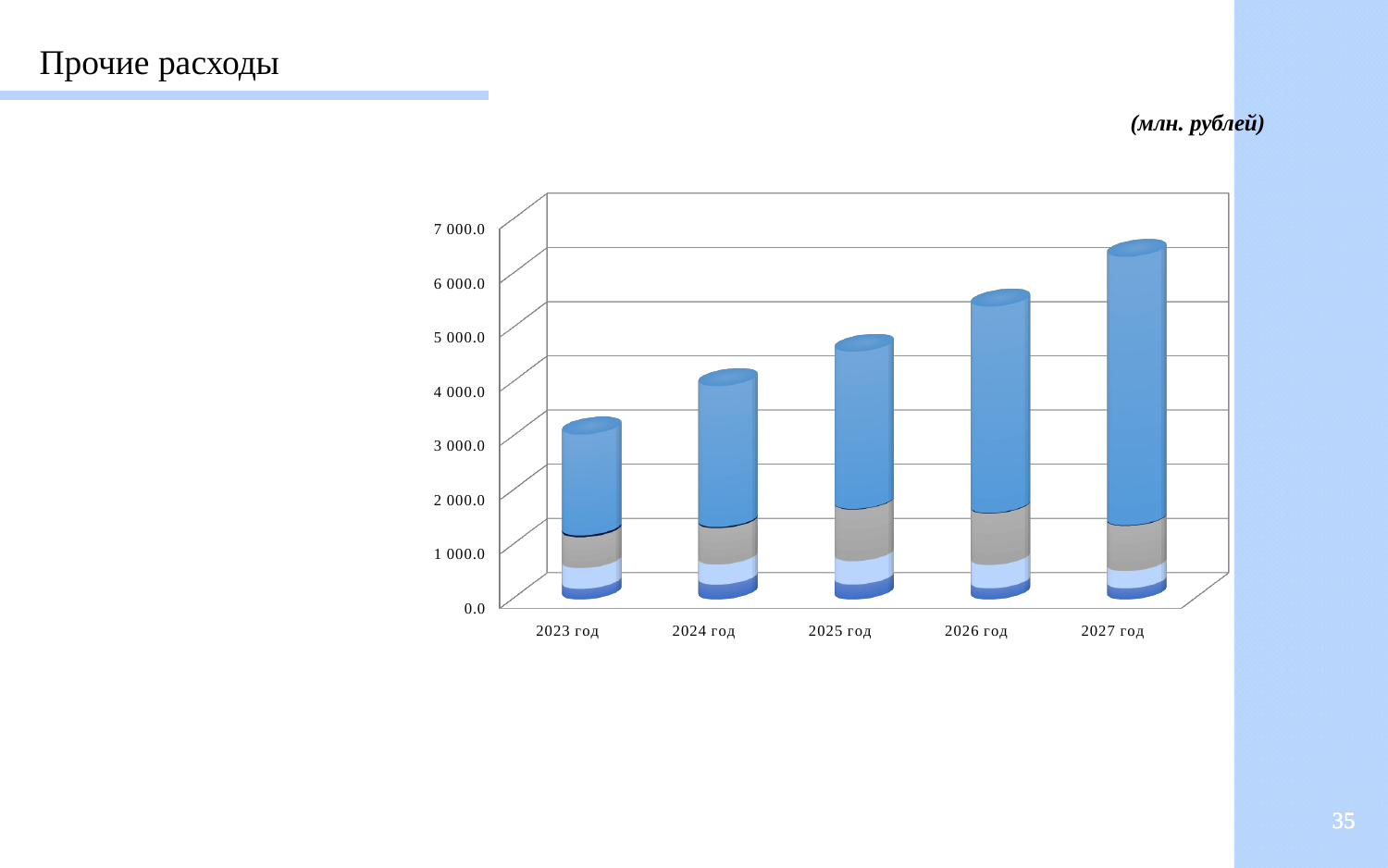
Is the total for 2023 год greater or less than 4 000.0? less Do the bar totals rise or fall from 2023 год to 2027 год? rise Which year has the tallest bar in the chart? 2027 год What is the title of the slide containing the chart? Прочие расходы Which year has the shortest bar in the chart? 2023 год What kind of chart is shown on the slide? bar chart Is the total for 2026 год greater or less than 4 000.0? greater How many years are shown on the x axis of the chart? 5 Is the total for 2024 год greater or less than 5 000.0? less In what units are the chart values given, according to the slide? млн. рублей Which bar is taller, 2023 год or 2027 год? 2027 год